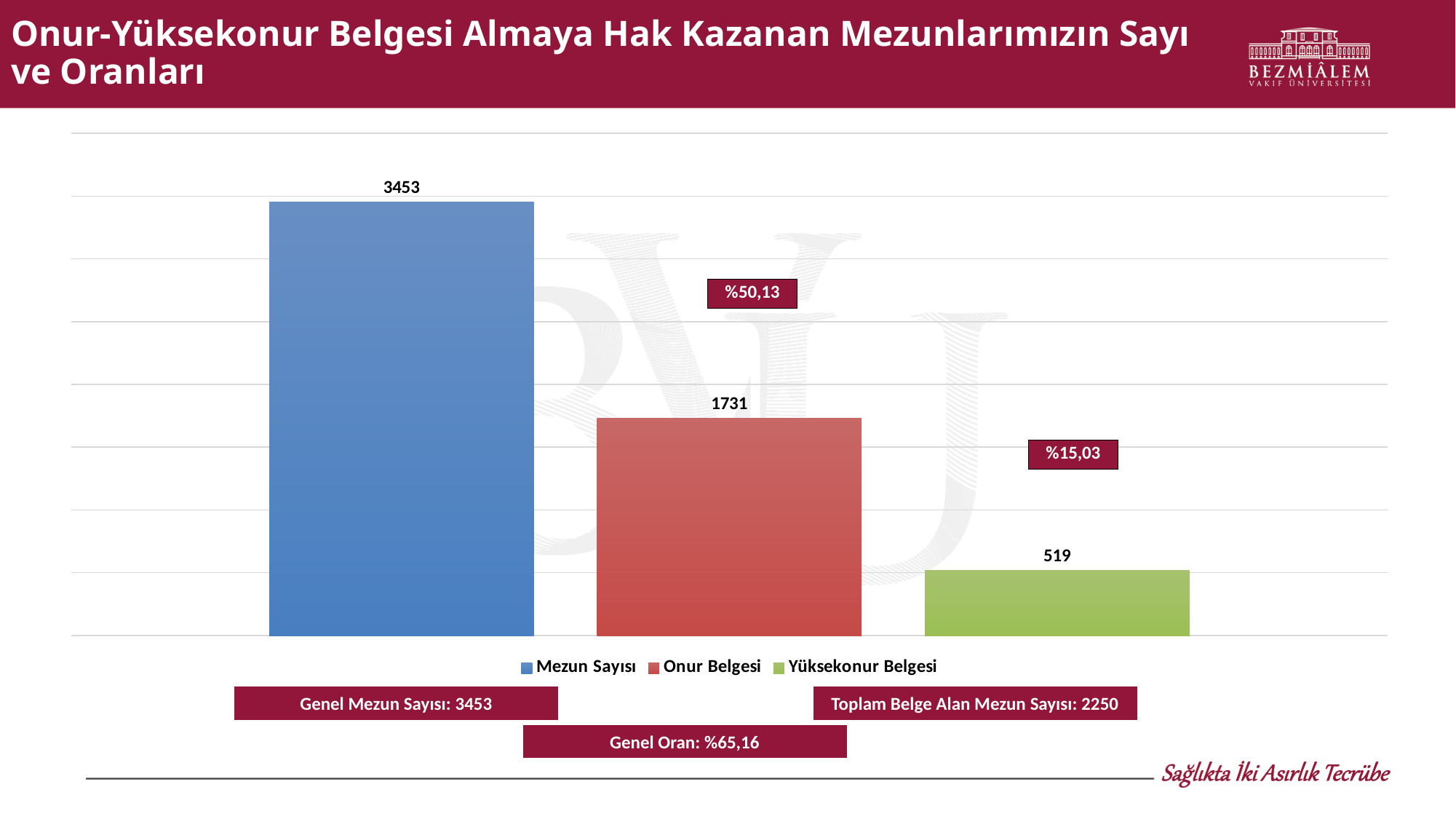
What colour is the Yüksekonur Belgesi bar? Green What is the difference between the Mezun Sayısı value and the Onur Belgesi value? 1722 How many series does the legend list? 3 What is the value for Mezun Sayısı? 3453 What kind of chart is shown on the slide? Bar chart What is the value for Yüksekonur Belgesi? 519 What is the value for Onur Belgesi? 1731 Which series has the lowest value? Yüksekonur Belgesi Which is larger, the value for Onur Belgesi or the value for Yüksekonur Belgesi? Onur Belgesi Which series has the highest value? Mezun Sayısı What percentage label is shown next to the Onur Belgesi bar? %50,13 What is the difference between the Onur Belgesi value and the Yüksekonur Belgesi value? 1212